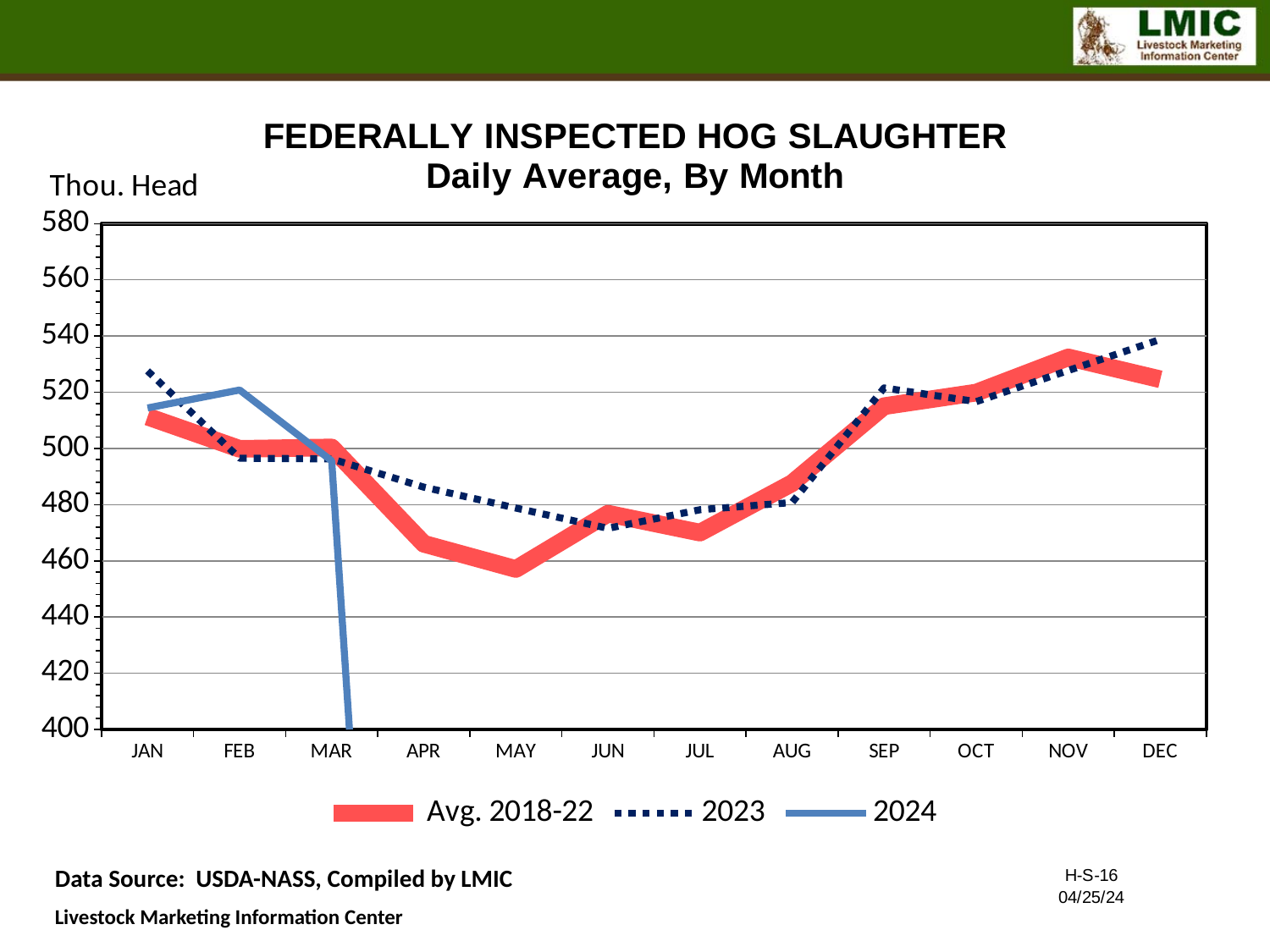
Which series is drawn as a dotted line? 2023 In which month is the 2023 series at its highest? DEC Does the Avg. 2018-22 series rise or fall from MAY to NOV? rise In which month is the Avg. 2018-22 series at its highest? NOV How many series does the legend list? 3 What type of chart is shown on the slide? line chart What is the unit label shown above the y axis? Thou. Head Is the 2023 value for JAN greater or less than 520? greater Is the Avg. 2018-22 value for MAY greater or less than 460? less In which month is the Avg. 2018-22 series at its lowest? MAY In APR, which series is higher: Avg. 2018-22 or 2023? 2023 How many months are shown along the x axis? 12